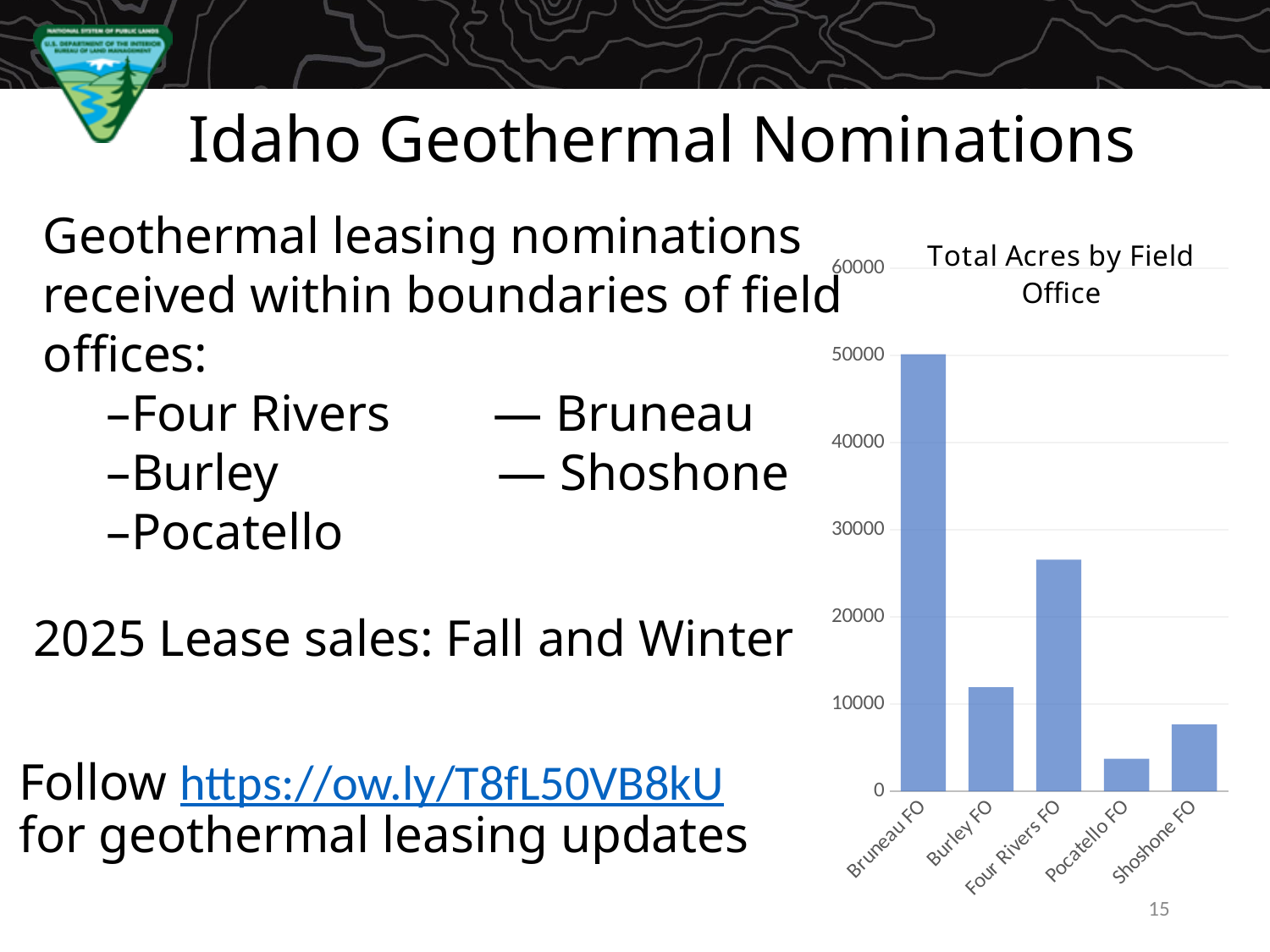
Which has more total acres, Shoshone FO or Pocatello FO? Shoshone FO Which field office has the highest total acres? Bruneau FO Is the value for Shoshone FO greater or less than 10000? less Which field office has the lowest total acres? Pocatello FO What is the title of the chart? Total Acres by Field Office Which field office has the second-highest total acres? Four Rivers FO What kind of chart is shown on the slide? bar chart How many field offices are shown on the x axis of the chart? 5 Is the value for Bruneau FO greater or less than 40000? greater Is the value for Burley FO greater or less than 20000? less Which has more total acres, Burley FO or Four Rivers FO? Four Rivers FO